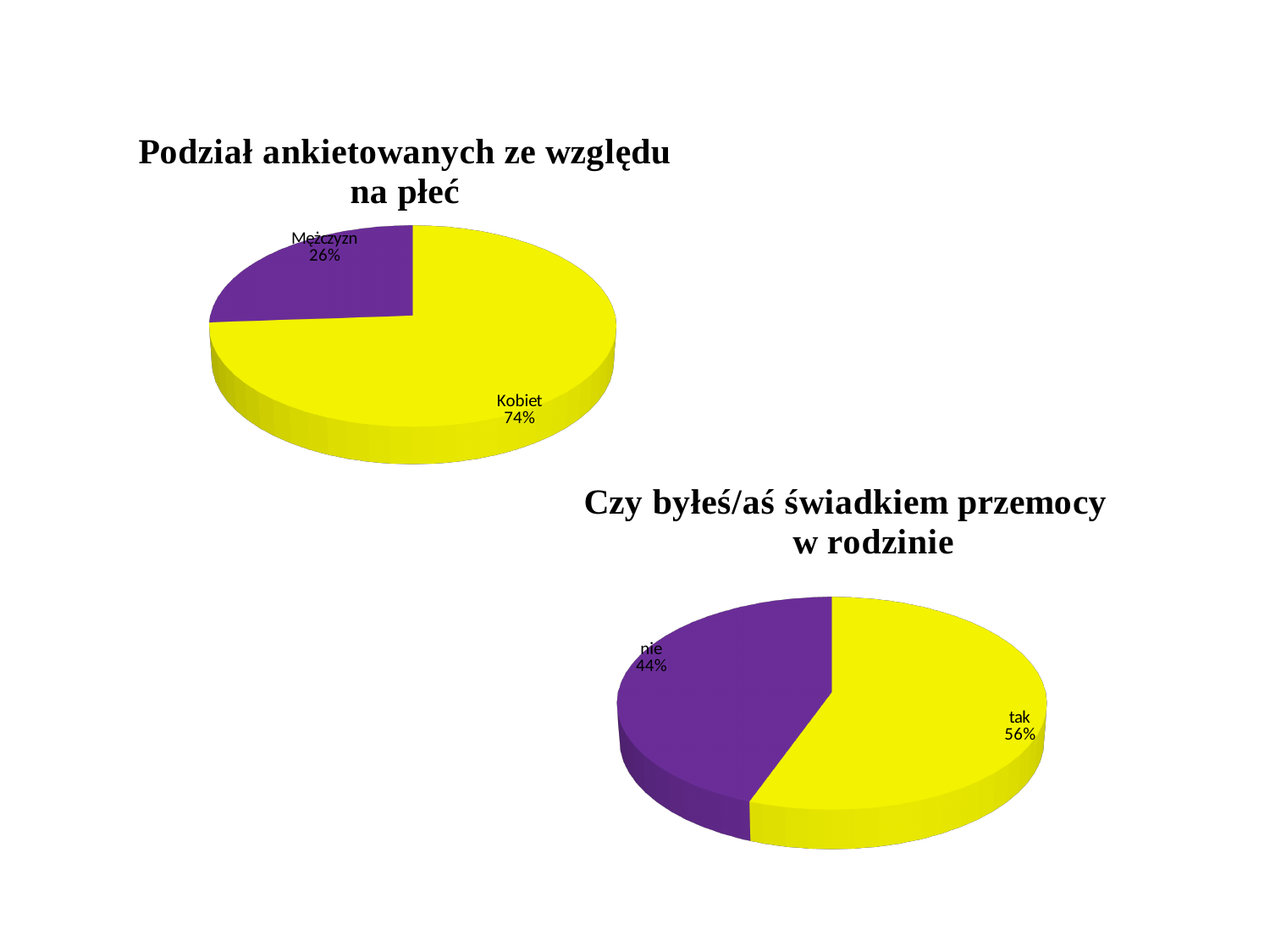
In the chart titled "Podział ankietowanych ze względu na płeć", which slice is the largest? Kobiet In the chart titled "Podział ankietowanych ze względu na płeć", what share of respondents are Kobiet? 74% In the chart titled "Czy byłeś/aś świadkiem przemocy w rodzinie", what share of respondents answered nie? 44% What kind of chart is the one titled "Podział ankietowanych ze względu na płeć"? Pie chart In the chart titled "Czy byłeś/aś świadkiem przemocy w rodzinie", what colour is the tak slice? Yellow In the chart titled "Czy byłeś/aś świadkiem przemocy w rodzinie", which is larger, tak or nie? tak In the chart titled "Czy byłeś/aś świadkiem przemocy w rodzinie", what share of respondents answered tak? 56% In the chart titled "Czy byłeś/aś świadkiem przemocy w rodzinie", which slice is the smallest? nie In the chart titled "Czy byłeś/aś świadkiem przemocy w rodzinie", what is the difference in percentage points between tak and nie? 12 percentage points In the chart titled "Podział ankietowanych ze względu na płeć", what is the difference in percentage points between Kobiet and Mężczyzn? 48 percentage points In the chart titled "Podział ankietowanych ze względu na płeć", what share of respondents are Mężczyzn? 26% In the chart titled "Podział ankietowanych ze względu na płeć", how many slices does the pie have? 2